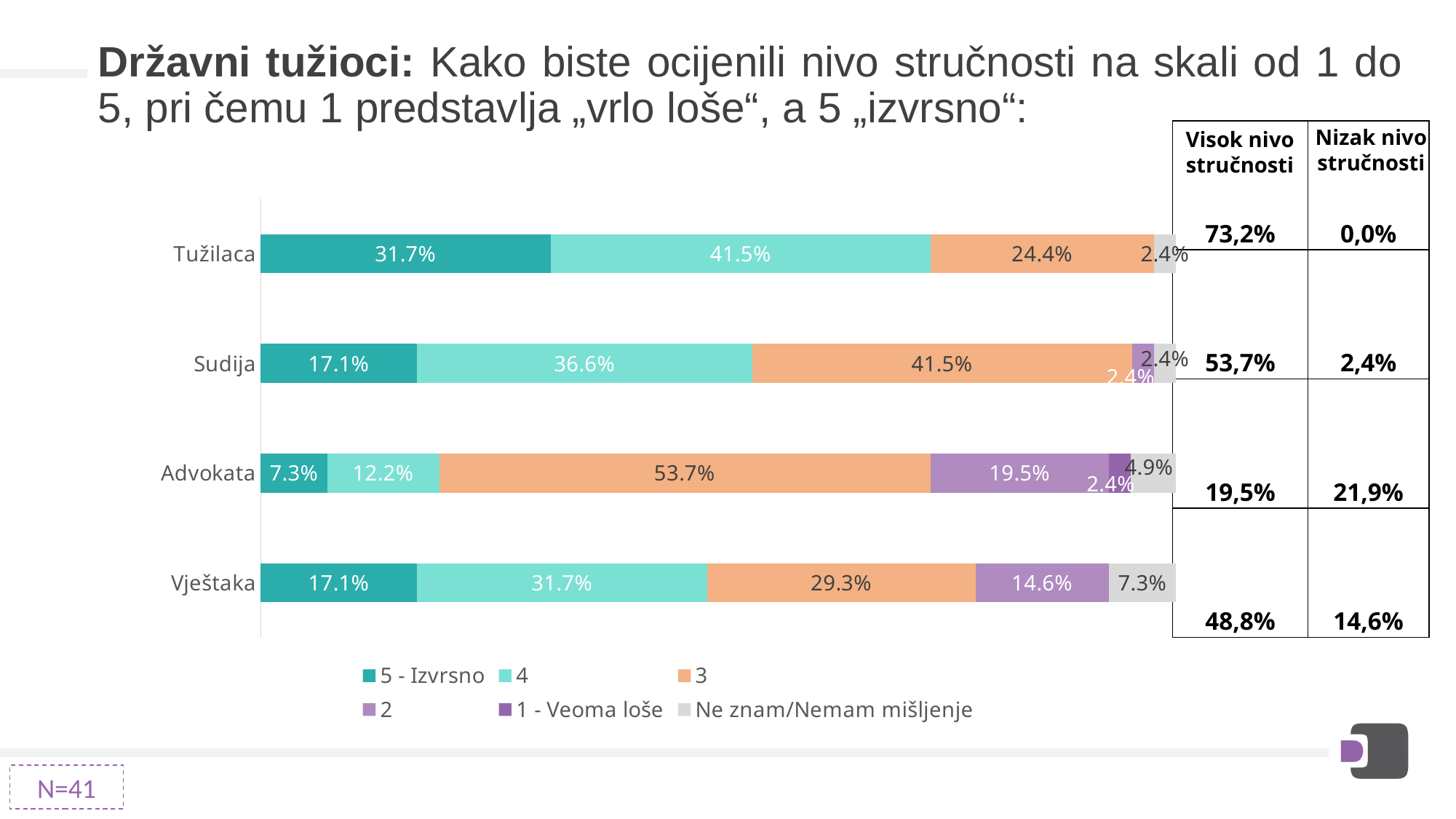
How many categories are plotted on the chart? 4 Which category has the lowest value for the "5 - Izvrsno" series? Advokata What is the value of the "2" series for Vještaka? 14.6% What is the value of the "3" series for Advokata? 53.7% What kind of chart is shown on the slide? Stacked bar chart What is the value of the "4" series for Sudija? 36.6% Which category has the highest value for the "5 - Izvrsno" series? Tužilaca Which is larger: the "4" series value for Tužilaca or for Vještaka? Tužilaca What is the value of the "5 - Izvrsno" series for Tužilaca? 31.7% How many series does the legend list? 6 What is the difference between the "3" series values for Advokata and Tužilaca? 29.3% What is the value of the "Ne znam/Nemam mišljenje" series for Vještaka? 7.3%